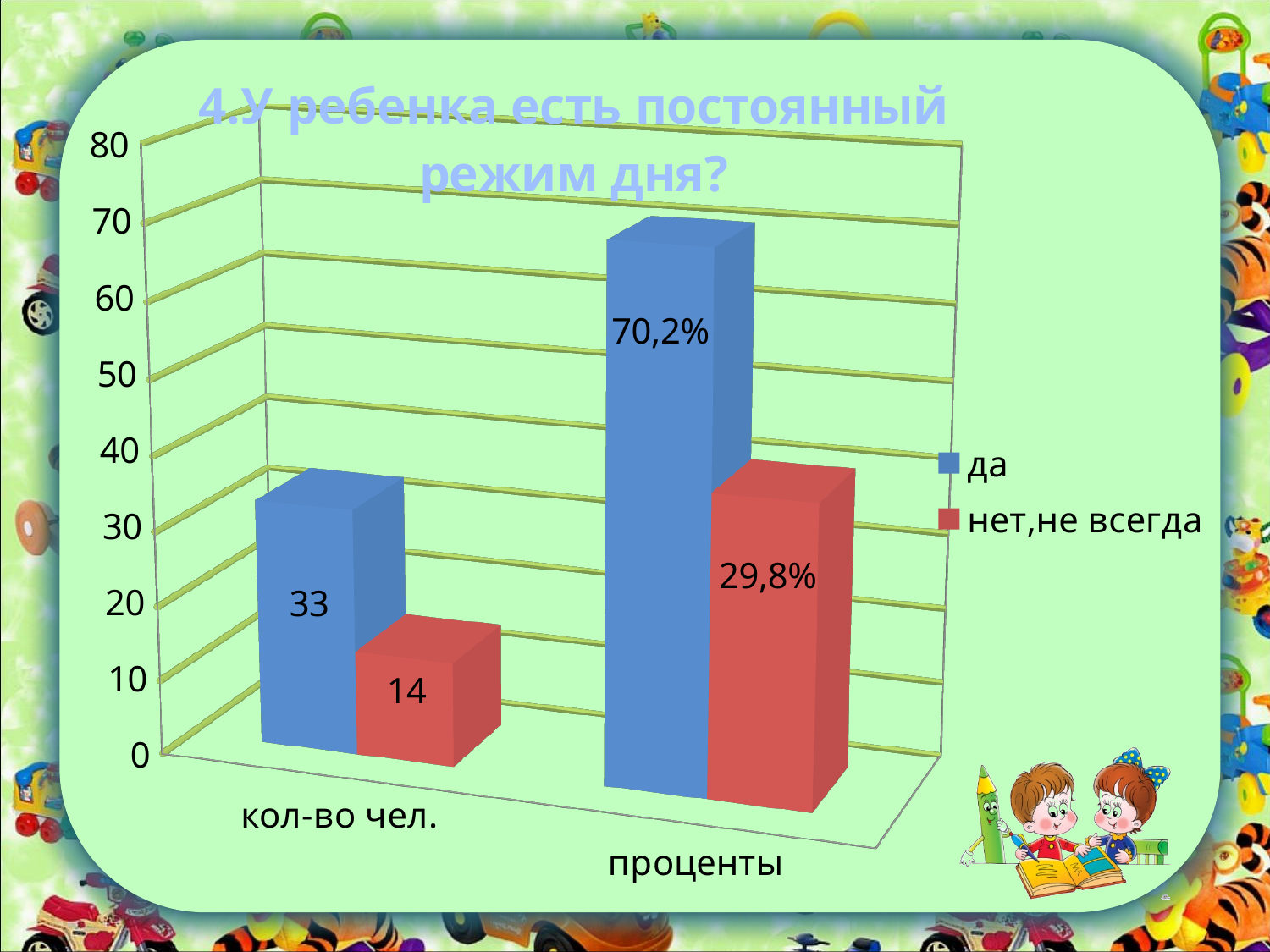
What kind of chart is shown on the slide? bar chart What colour represents the "нет,не всегда" series? red How many series does the legend list? 2 What is the value for "да" in the "кол-во чел." category? 33 Which series has the higher value in the "кол-во чел." category? да How many categories are shown on the x axis? 2 Which series has the lower value in the "проценты" category? нет,не всегда What is the value for "нет,не всегда" in the "кол-во чел." category? 14 What is the difference between the "да" and "нет,не всегда" values in the "кол-во чел." category? 19 What is the value for "да" in the "проценты" category? 70,2% What is the total of the "да" and "нет,не всегда" values in the "кол-во чел." category? 47 What is the value for "нет,не всегда" in the "проценты" category? 29,8%